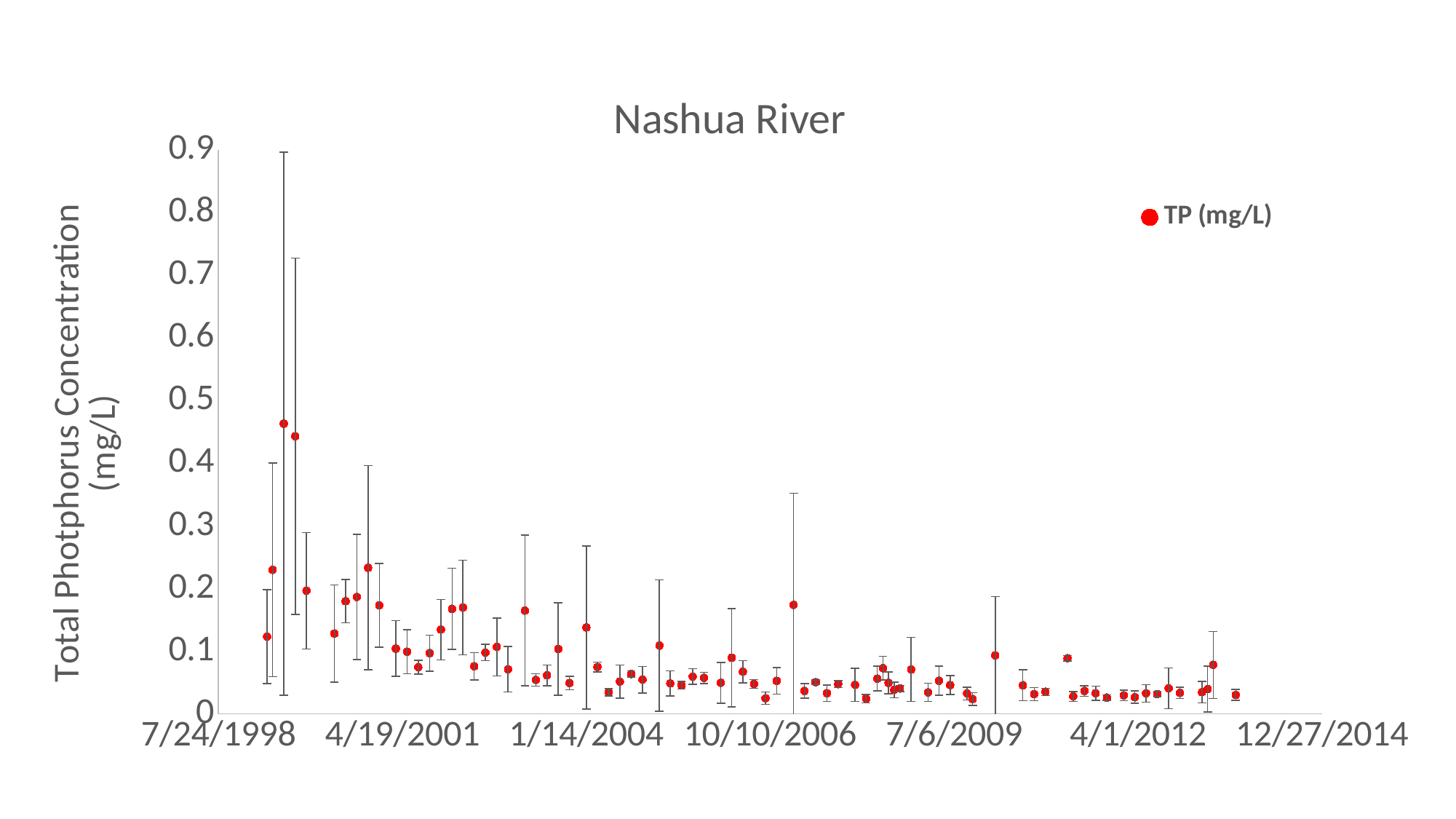
Is the highest plotted TP value greater or less than 0.4? greater Is the highest plotted TP value greater or less than 0.5? less Do the plotted TP values generally rise or fall from left to right along the x axis? fall What is the last date label shown on the x axis? 12/27/2014 How many date labels are shown on the x axis? 7 Are the TP values plotted after 7/6/2009 greater or less than 0.2? less What is the name of the series shown in the legend? TP (mg/L) How many series does the legend list? 1 What is the first date label shown on the x axis? 7/24/1998 What kind of chart is shown on the slide? scatter chart What is the highest value shown on the y axis? 0.9 What is the title of the chart? Nashua River